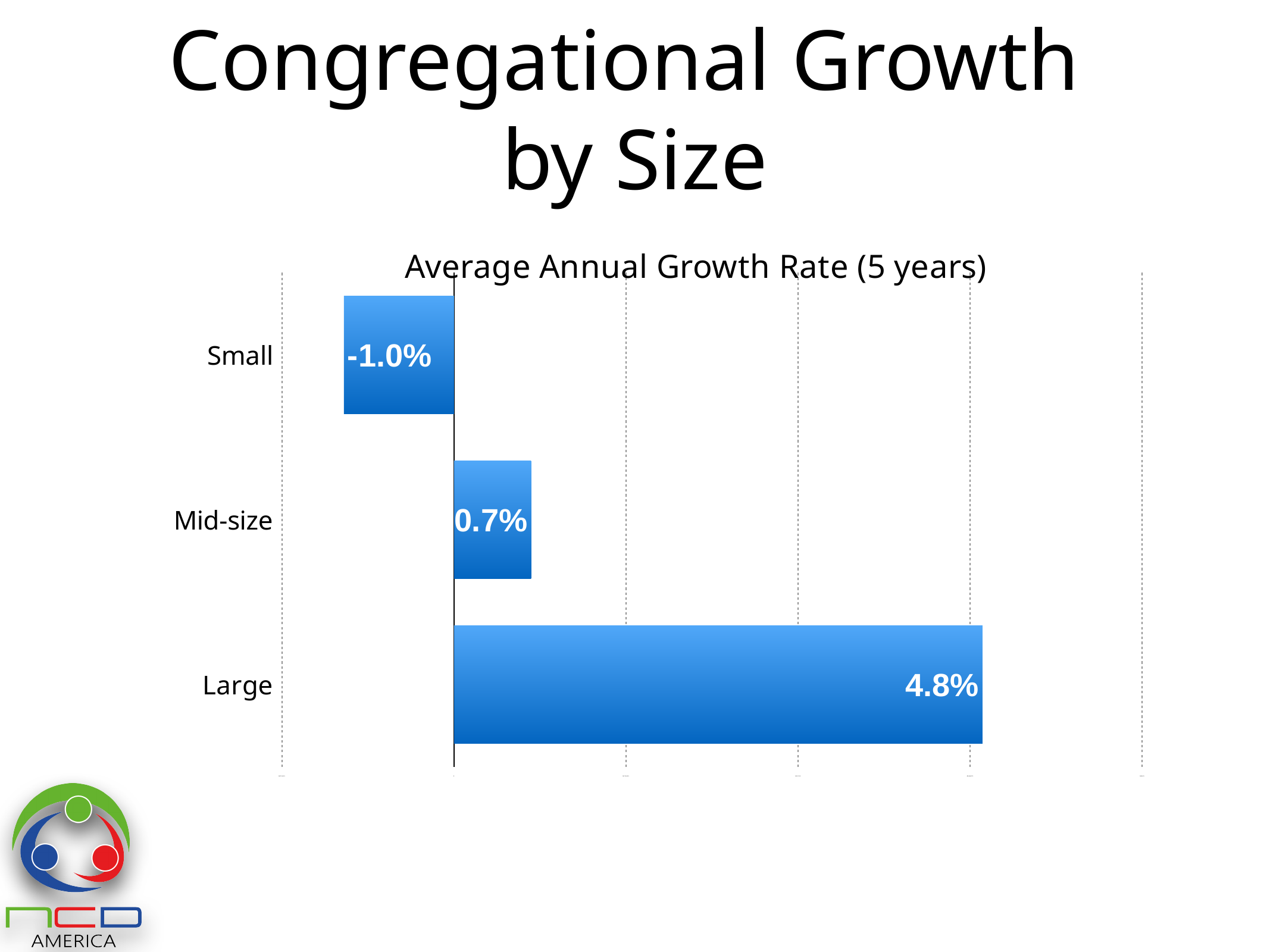
What is the average annual growth rate for Small congregations? -1.0% What is the average annual growth rate for Large congregations? 4.8% What is the difference between the growth rates of Mid-size and Small congregations? 1.7% What is the difference between the growth rates of Large and Mid-size congregations? 4.1% What is the average annual growth rate for Mid-size congregations? 0.7% How many congregation size categories are shown in the chart? 3 Which congregation size has the lowest average annual growth rate? Small What type of chart is shown on the slide? Bar chart Which congregation size category has a negative growth rate? Small Which congregation size has the highest average annual growth rate? Large Which has a higher average annual growth rate, Small or Mid-size congregations? Mid-size What is the title of the chart? Average Annual Growth Rate (5 years)